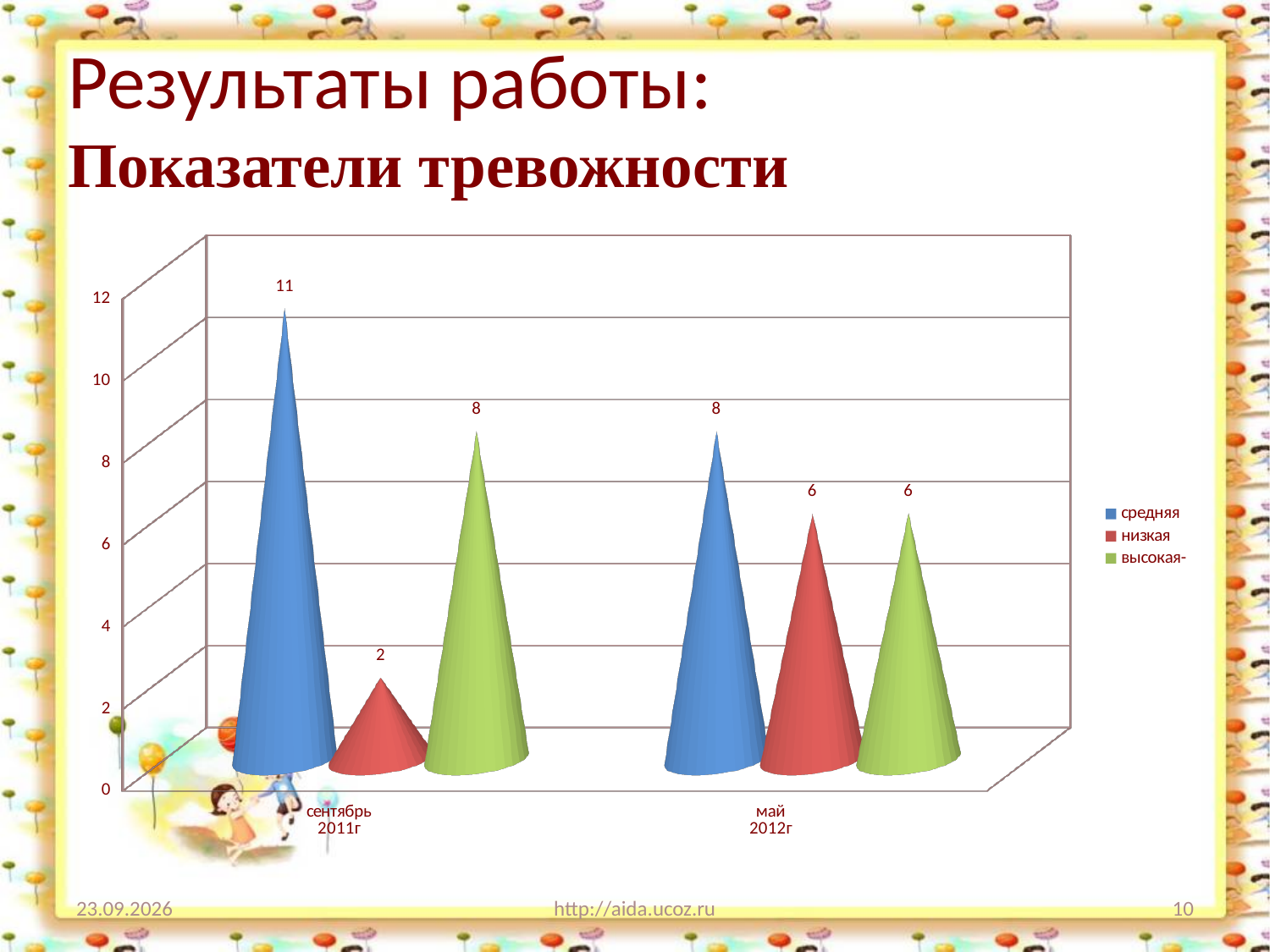
What is the value for средняя in май 2012г? 8 What is the value for средняя in сентябрь 2011г? 11 What is the value for низкая in сентябрь 2011г? 2 Which series has the lowest value in сентябрь 2011г? низкая What is the value for высокая- in май 2012г? 6 Does the value for высокая- rise or fall from сентябрь 2011г to май 2012г? fall How many categories are shown on the x axis? 2 How many series does the legend list? 3 What is the difference between the средняя values for сентябрь 2011г and май 2012г? 3 Which series has the highest value in сентябрь 2011г? средняя What kind of chart is shown on the slide? bar chart Which is larger: низкая in сентябрь 2011г or низкая in май 2012г? низкая in май 2012г